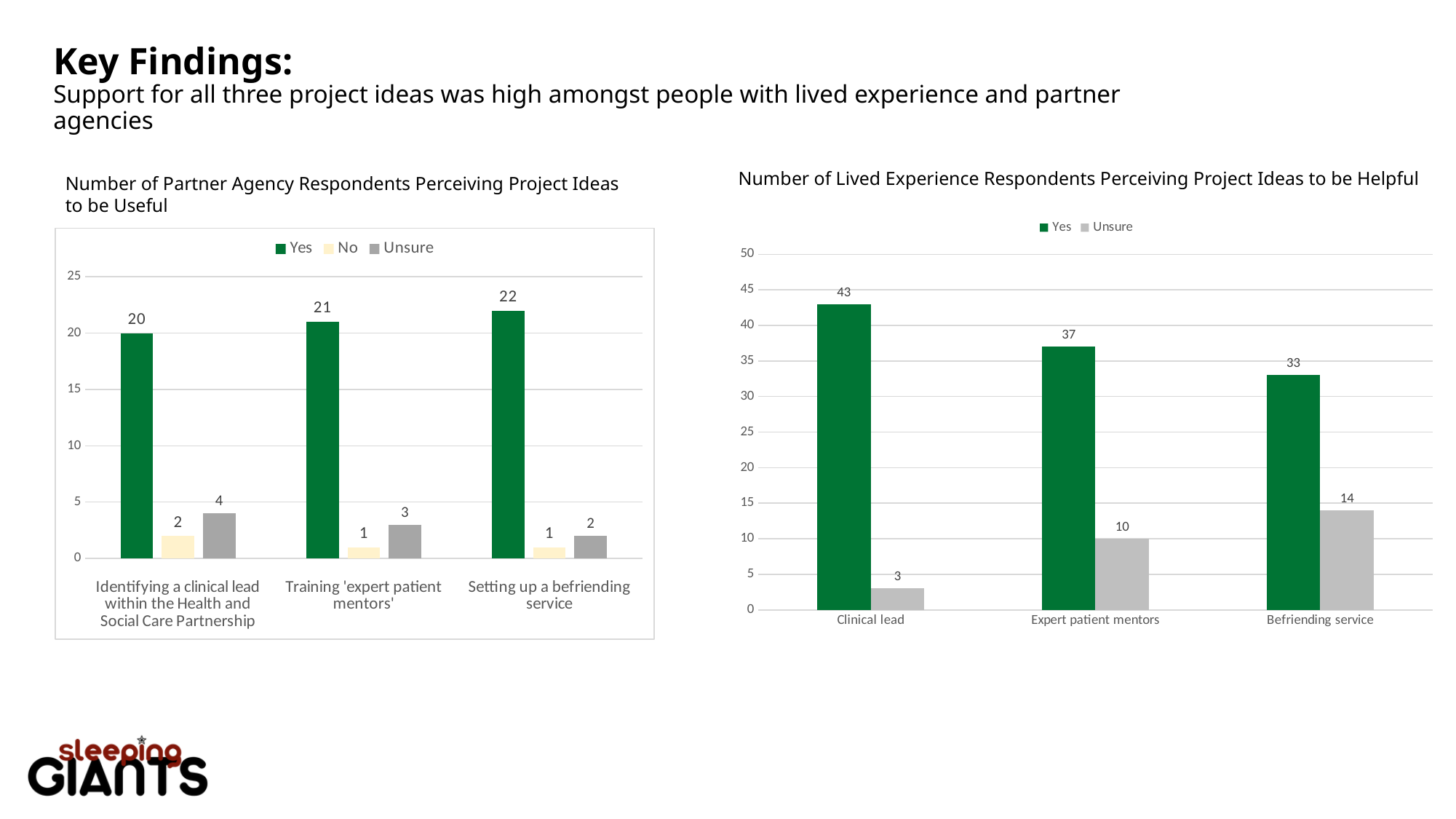
In the right chart (Lived Experience Respondents), what is the difference between the 'Yes' and 'Unsure' values for 'Clinical lead'? 40 In the left chart (Partner Agency Respondents), which project idea has the highest 'Unsure' value? Identifying a clinical lead within the Health and Social Care Partnership In the right chart (Lived Experience Respondents), is the 'Unsure' value for 'Befriending service' larger or smaller than the 'Unsure' value for 'Clinical lead'? larger In the right chart (Lived Experience Respondents), which project idea has the lowest 'Yes' value? Befriending service In the right chart (Lived Experience Respondents), what is the 'Unsure' value for 'Expert patient mentors'? 10 How many series does the legend of the left chart (Partner Agency Respondents) list? 3 How many series does the legend of the right chart (Lived Experience Respondents) list? 2 How many project idea categories are shown in the right chart (Lived Experience Respondents)? 3 In the right chart (Lived Experience Respondents), do the 'Yes' values rise or fall from left to right across the categories? fall In the left chart (Partner Agency Respondents), what is the difference between the 'Yes' values for 'Training 'expert patient mentors'' and 'Identifying a clinical lead within the Health and Social Care Partnership'? 1 In the left chart (Partner Agency Respondents), what is the 'Yes' value for 'Setting up a befriending service'? 22 What kind of chart is the left chart (Partner Agency Respondents)? bar chart